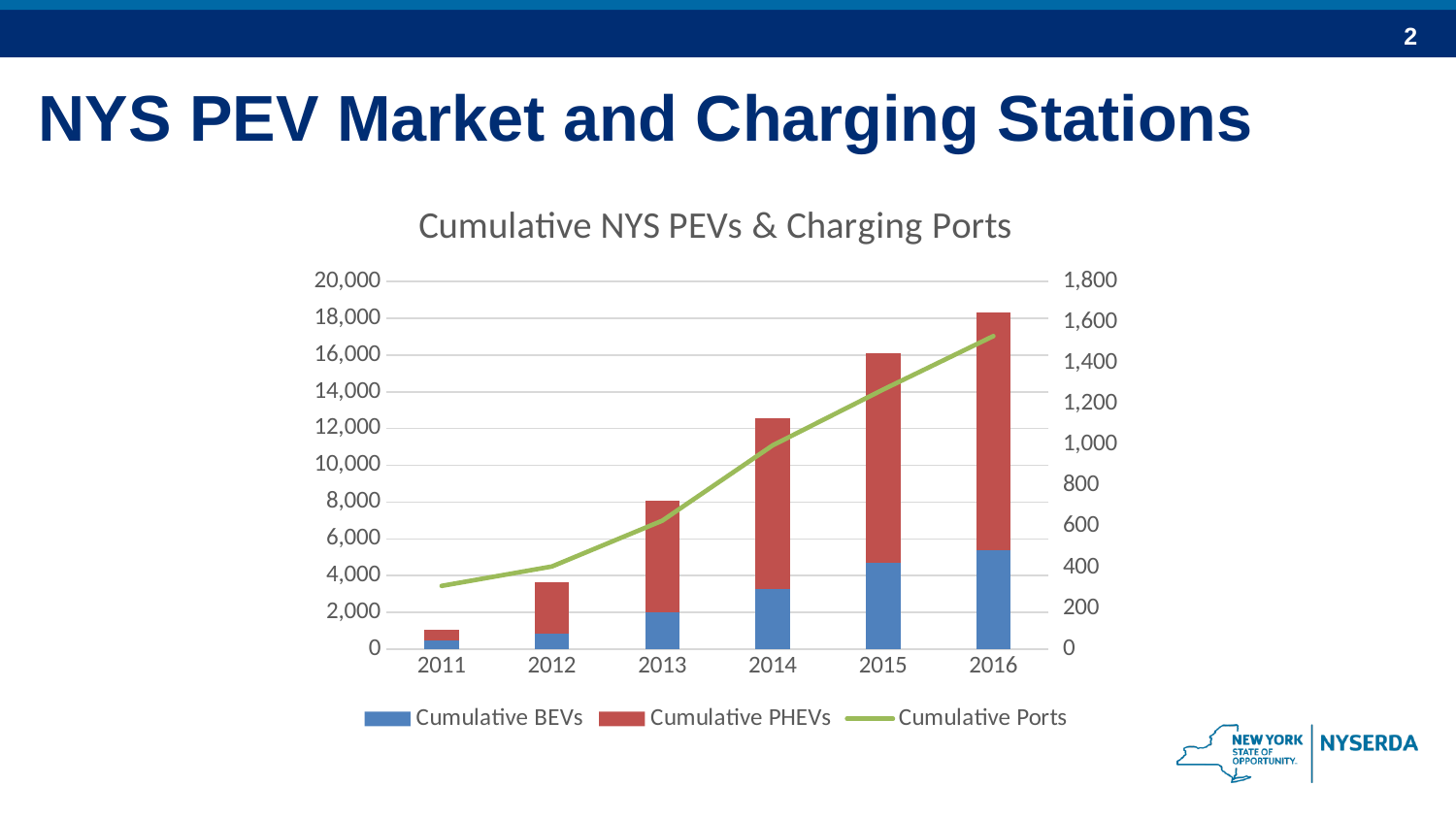
How many years are shown on the x axis? 6 How many series does the legend list? 3 Which year has the shortest stacked bar? 2011 Is the total stacked bar for 2013 greater or less than 10,000? less Which is larger, the total stacked bar for 2014 or for 2013? 2014 Is the Cumulative Ports value for 2011 greater or less than 400 on the right axis? less What kind of chart is shown on the slide? A combined stacked bar and line chart What is the title of the chart? Cumulative NYS PEVs & Charging Ports Which year has the tallest stacked bar? 2016 Is the total stacked bar for 2016 greater or less than 16,000? greater Do the Cumulative Ports values rise or fall from 2011 to 2016? Rise